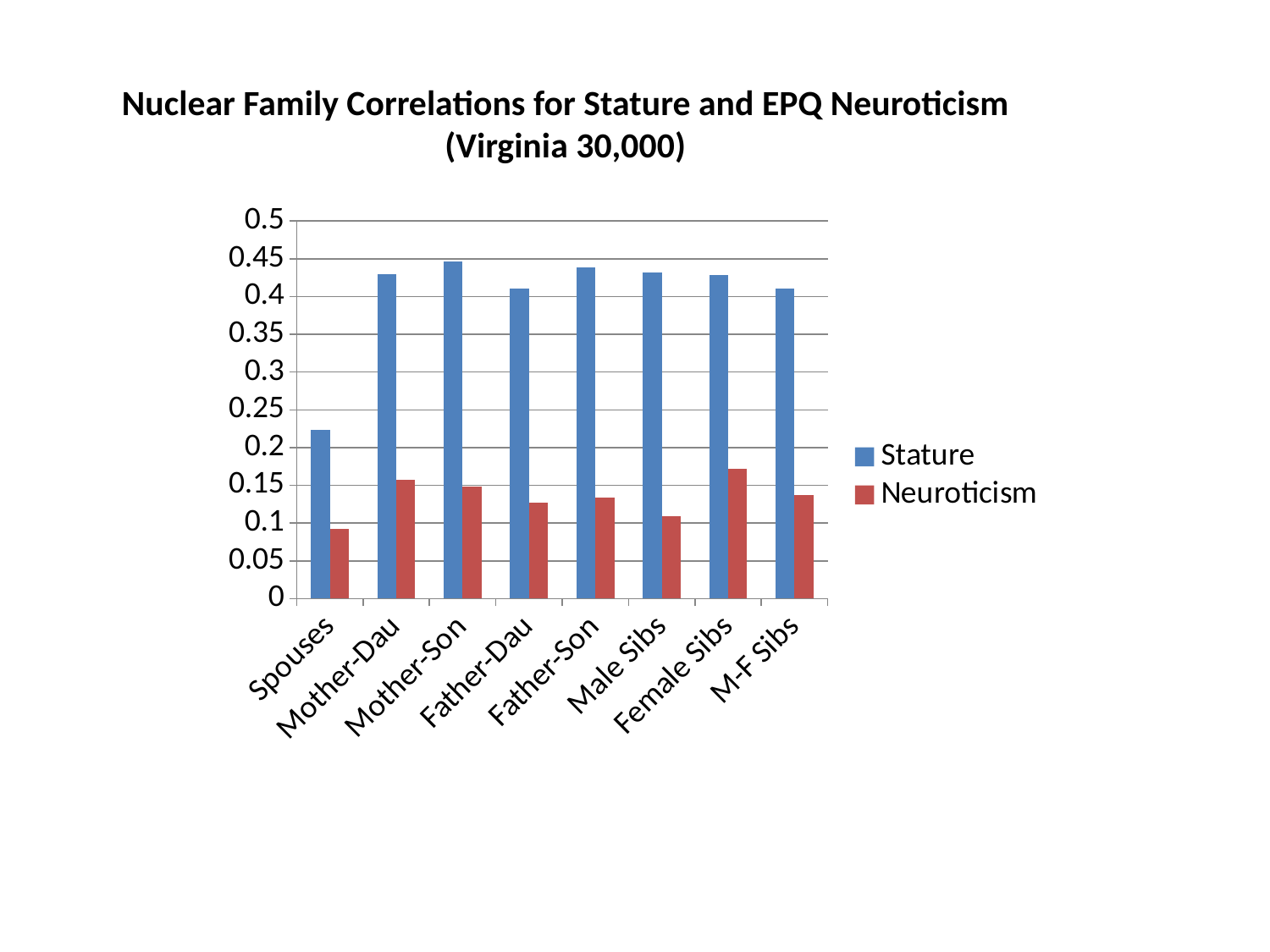
Which category has the lowest Neuroticism correlation? Spouses What kind of chart is shown on the slide? bar chart For Father-Son, which is larger, the Stature correlation or the Neuroticism correlation? Stature Which series is shown in blue? Stature Is the Stature value for Spouses greater or less than 0.25? less How many family relationship categories are shown on the x axis? 8 Is the Neuroticism value for Spouses greater or less than 0.1? less How many series does the legend list? 2 Is the Neuroticism value for Female Sibs greater or less than 0.15? greater Which category has the highest Neuroticism correlation? Female Sibs Which category has the lowest Stature correlation? Spouses